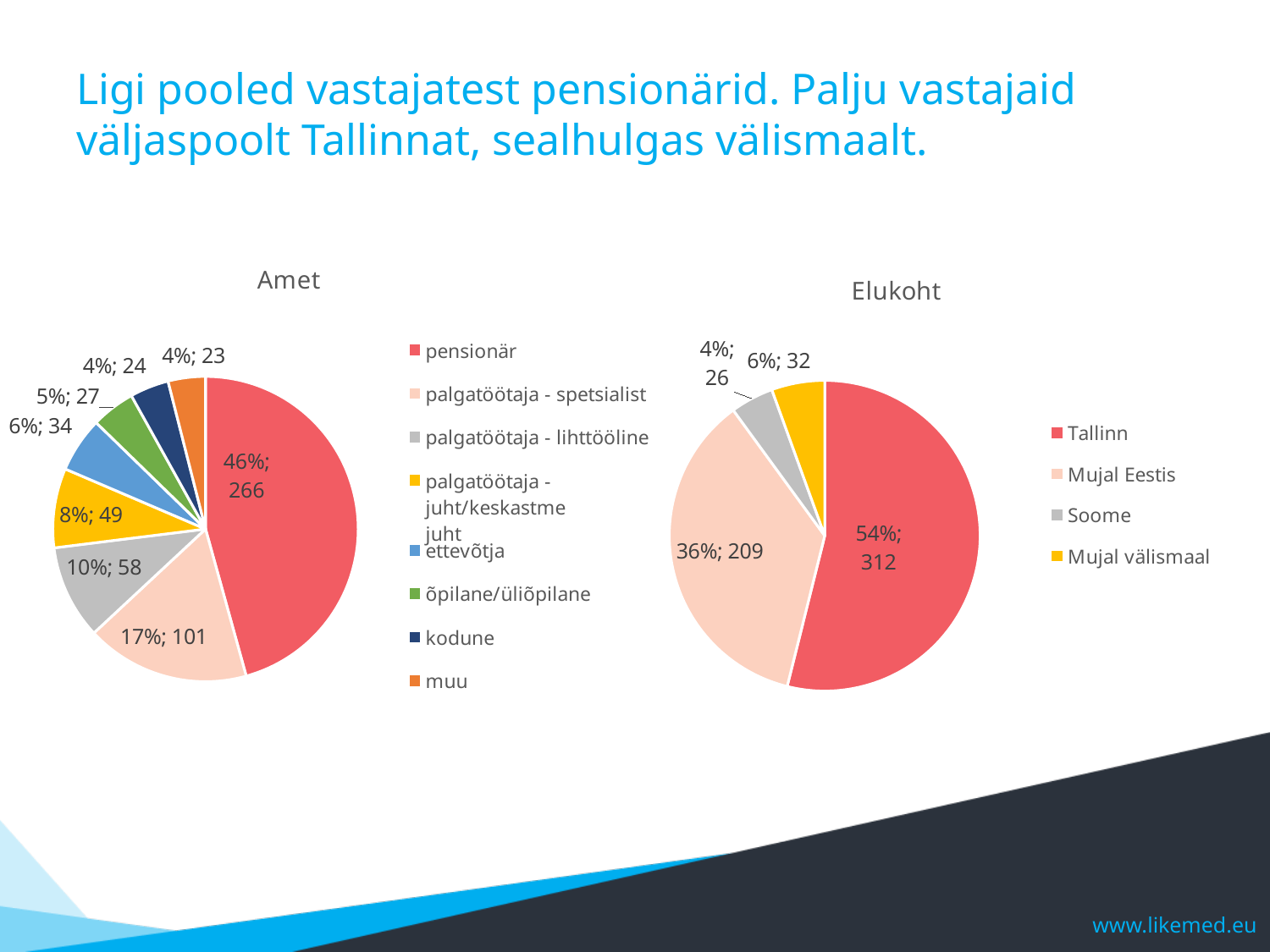
In the "Amet" chart, what share of the pie is õpilane/üliõpilane? 5% In the "Elukoht" chart, what colour is the Soome slice? grey In the "Amet" chart, what is the difference in count between palgatöötaja - lihttööline and ettevõtja? 24 In the "Amet" chart, which is larger: kodune or muu? kodune In the "Amet" chart, what value is shown for pensionär? 46%; 266 In the "Amet" chart, which category has the largest slice? pensionär In the "Elukoht" chart, which category has the smallest slice? Soome In the "Elukoht" chart, what is the difference in count between Tallinn and Mujal Eestis? 103 In the "Amet" chart, how many categories does the legend list? 8 What kind of chart is the "Elukoht" chart? pie chart In the "Elukoht" chart, what value is shown for Tallinn? 54%; 312 In the "Amet" chart, how many respondents are palgatöötaja - spetsialist? 101